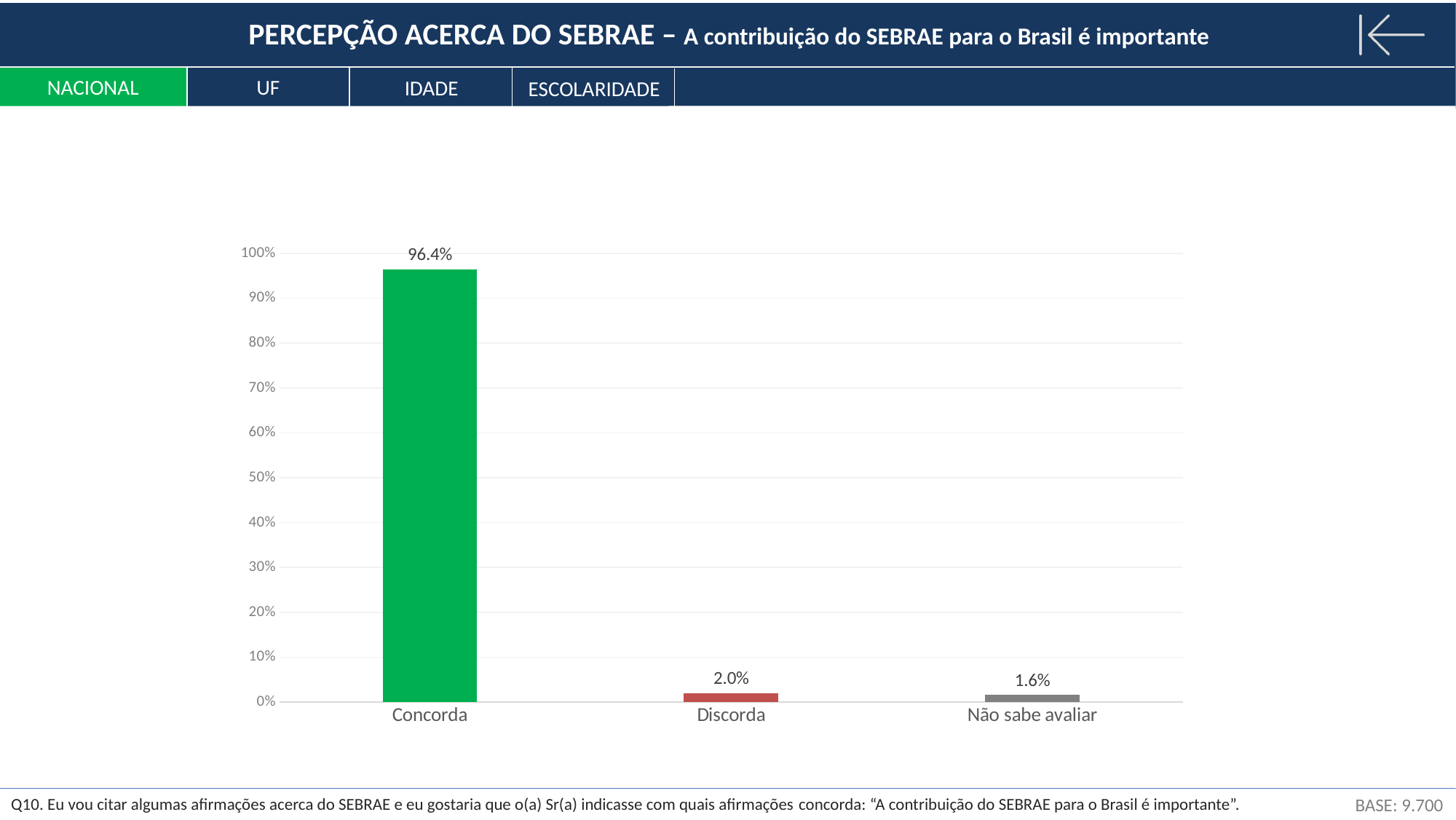
What is the difference between the values for Discorda and Não sabe avaliar? 0.4% Which is larger, the value for Discorda or the value for Não sabe avaliar? Discorda What colour is the bar for Concorda? green Which category has the highest value? Concorda Which category has the lowest value? Não sabe avaliar What kind of chart is shown on the slide? bar chart What is the value for Concorda? 96.4% Is the value for Concorda greater or less than 90%? greater What is the difference between the values for Concorda and Discorda? 94.4% How many categories are shown on the x axis? 3 What is the value for Não sabe avaliar? 1.6% What is the value for Discorda? 2.0%